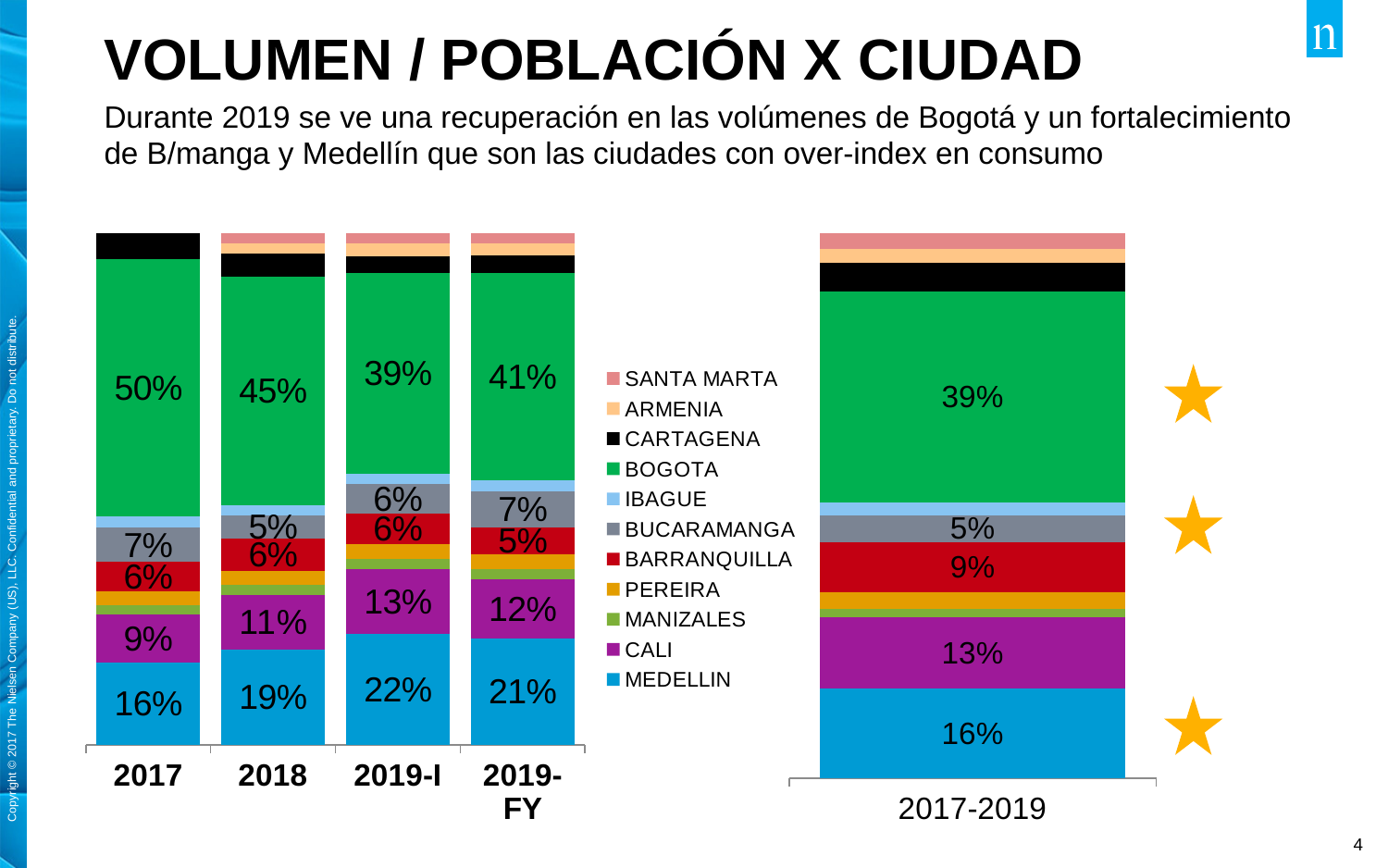
In the right chart (2017-2019), what is the value for BARRANQUILLA? 9% In the left chart, which is larger: the MEDELLIN share in 2017 or in 2018? 2018 How many cities does the legend list? 11 What is the x-axis label of the right chart? 2017-2019 In the left chart, what is the value for CALI in 2019-FY? 12% In the left chart, which city has the largest share in 2018? BOGOTA In the left chart, does the BOGOTA share rise or fall from 2017 to 2019-I? fall In the left chart, what is the value for BOGOTA in 2017? 50% In the left chart, what is the difference between the BOGOTA share in 2017 and in 2019-FY? 9% How many bars (periods) are shown in the left chart? 4 In the left chart, what is the value for MEDELLIN in 2019-I? 22% What kind of chart is the left chart? stacked bar chart